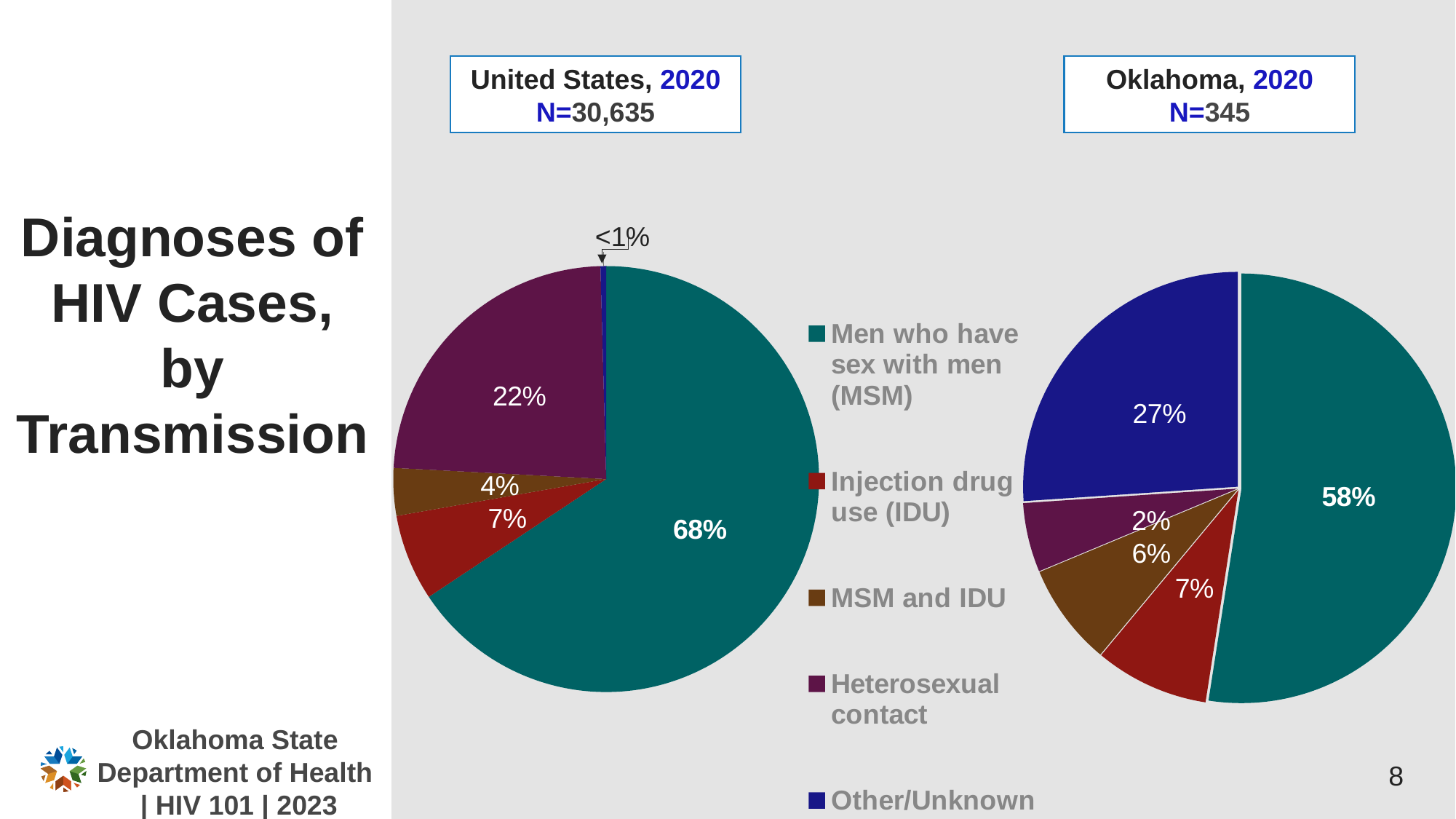
What is the difference between the MSM share in the United States, 2020 chart and the MSM share in the Oklahoma, 2020 chart? 10 percentage points In the United States, 2020 chart, what share of diagnoses is attributed to heterosexual contact? 22% In the United States, 2020 chart, what share of diagnoses is attributed to men who have sex with men (MSM)? 68% Which is larger: the heterosexual contact share in the United States, 2020 chart or in the Oklahoma, 2020 chart? United States, 2020 In the United States, 2020 chart, which transmission category has the smallest share? Other/Unknown What kind of charts are shown on the slide? Pie charts In the Oklahoma, 2020 chart, which transmission category has the largest share? Men who have sex with men (MSM) In the Oklahoma, 2020 chart, what share of diagnoses is attributed to MSM and IDU? 6% How many transmission categories does the legend list? 5 In the Oklahoma, 2020 chart, what share of diagnoses is attributed to Other/Unknown transmission? 27% What is the total number of cases (N) shown for the Oklahoma, 2020 chart? 345 In the Oklahoma, 2020 chart, which transmission category has the smallest share? Heterosexual contact